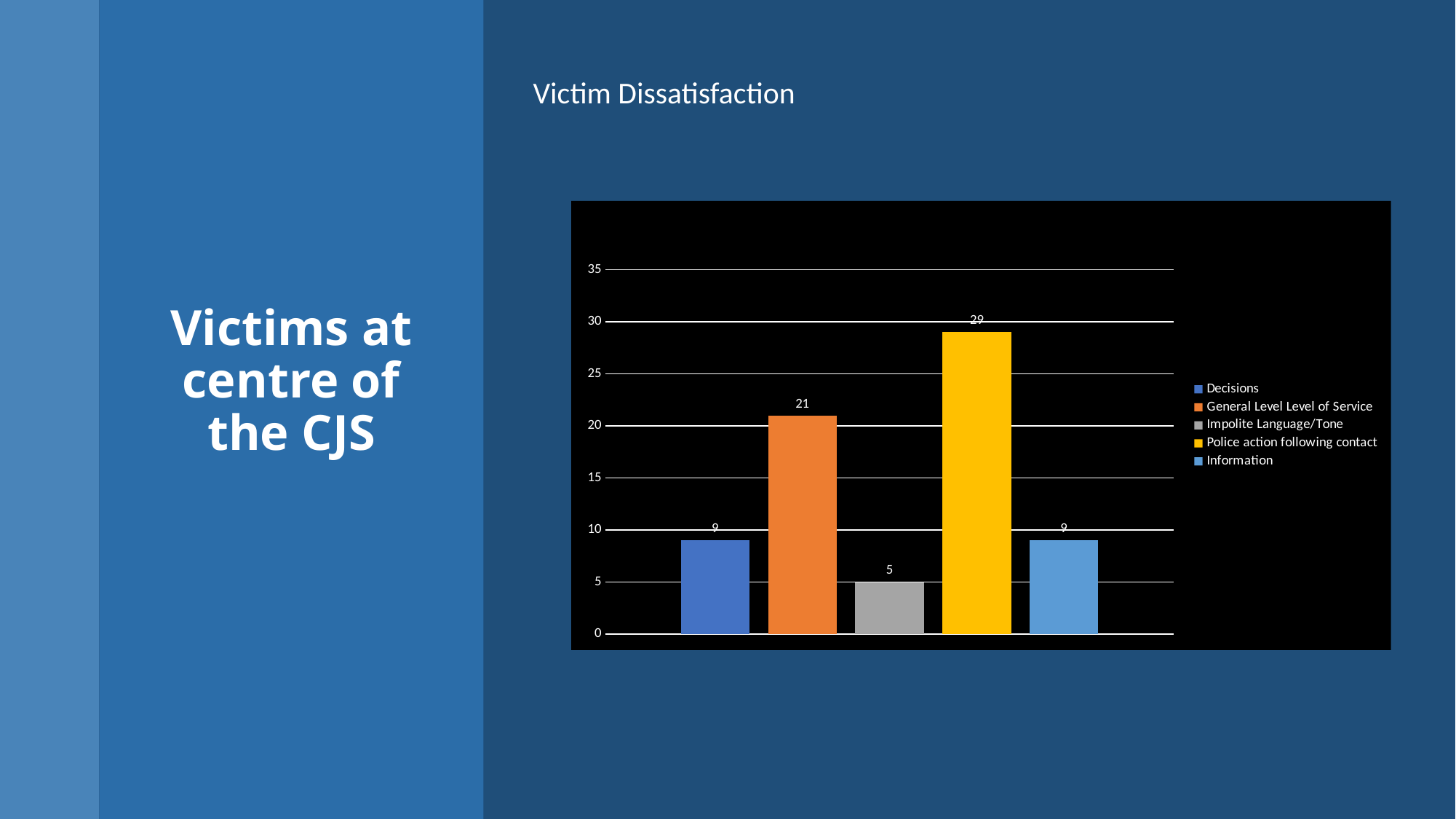
Which category has the highest value? Police action following contact What is the value for Decisions? 9 Which is larger, the value for General Level Level of Service or the value for Information? General Level Level of Service Is the value for Police action following contact greater or less than 25? greater What is the value for Impolite Language/Tone? 5 What is the value for Police action following contact? 29 What kind of chart is shown on the slide? bar chart What is the title of the chart? Victim Dissatisfaction How many series does the legend list? 5 What is the difference between the values for Police action following contact and General Level Level of Service? 8 What is the value for General Level Level of Service? 21 Which category has the lowest value? Impolite Language/Tone